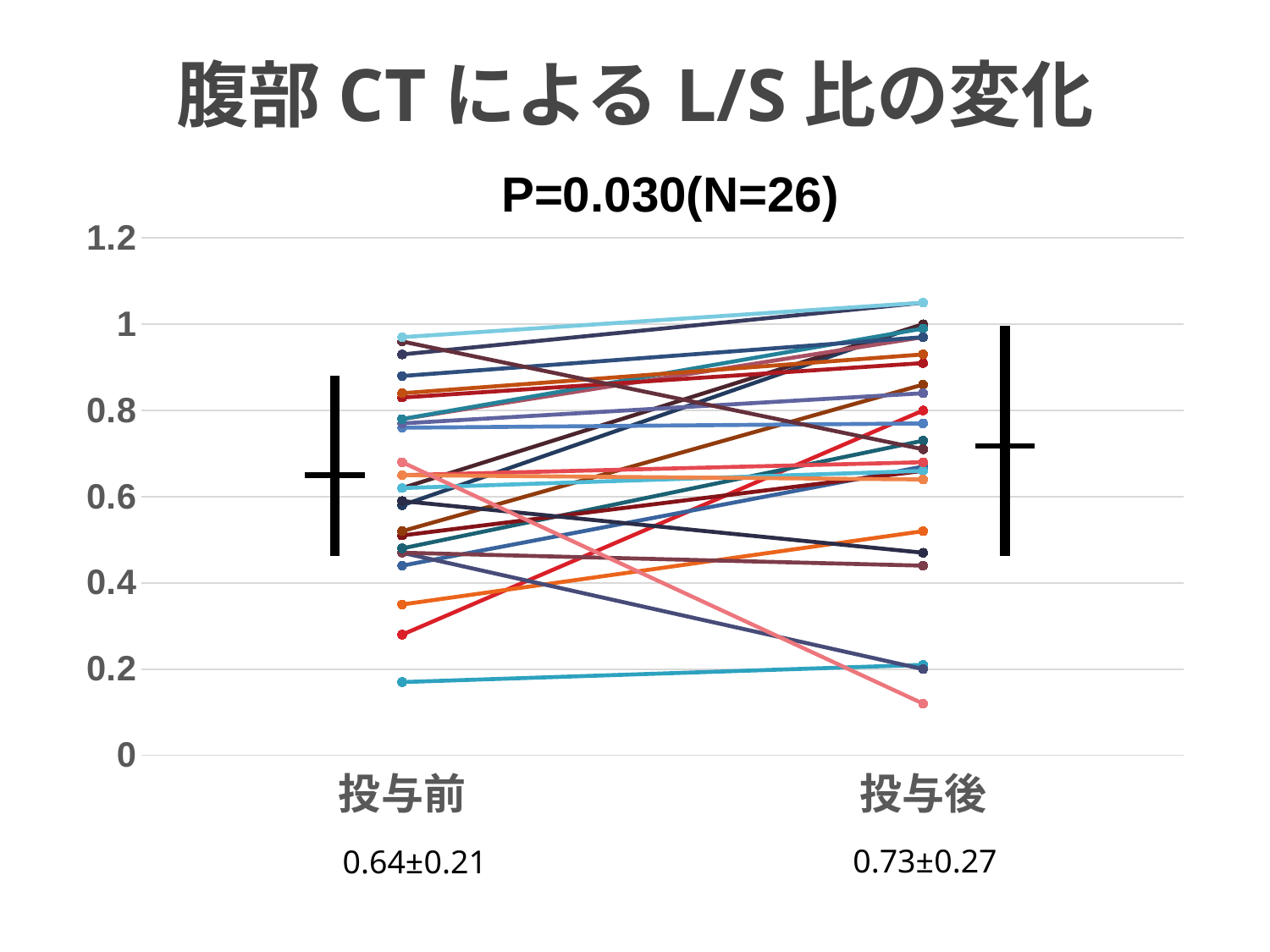
What is the N shown above the chart? 26 Is the highest individual value at 投与後 greater or less than 1? greater Which has the larger mean value, 投与前 or 投与後? 投与後 What is the mean ± SD value printed under 投与前? 0.64±0.21 Does the mean L/S ratio rise or fall from 投与前 to 投与後? rise How many categories are shown on the x axis? 2 Is the lowest individual value at 投与後 greater or less than 0.2? less Is the lowest individual value at 投与前 greater or less than 0.4? less What P value is printed above the chart? P=0.030 What is the mean ± SD value printed under 投与後? 0.73±0.27 What kind of chart is shown on the slide? line chart What is the title of the chart? 腹部 CT による L/S 比の変化